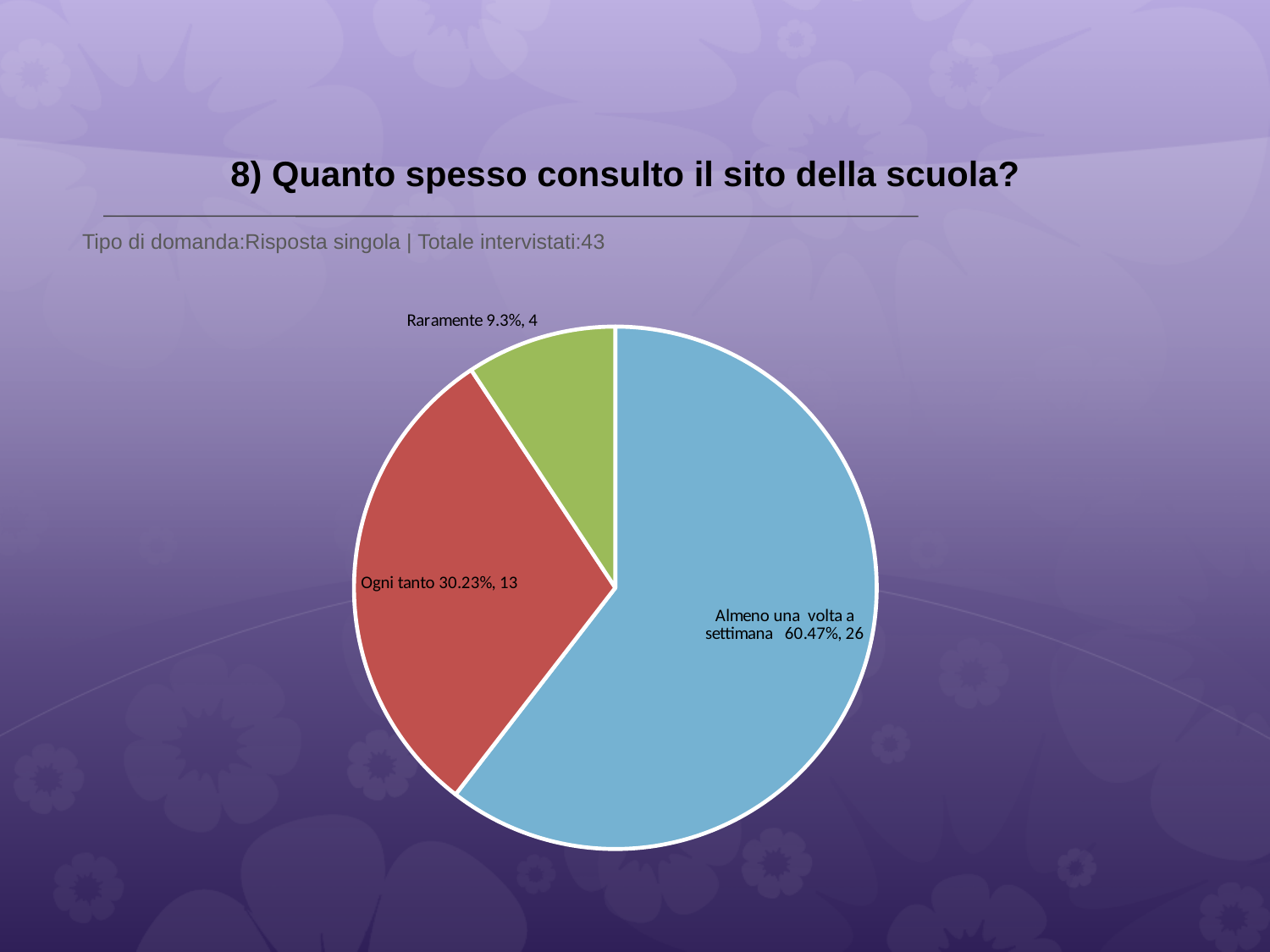
How many respondents chose 'Raramente'? 4 How many slices does the pie chart have? 3 Which category has the smallest slice? Raramente What percentage share does the 'Almeno una volta a settimana' slice have? 60.47% What colour is the 'Ogni tanto' slice? red What is the difference in respondent count between 'Almeno una volta a settimana' and 'Ogni tanto'? 13 What percentage share does the 'Raramente' slice have? 9.3% Which has more respondents, 'Ogni tanto' or 'Raramente'? Ogni tanto What is the total number of respondents across all slices? 43 What kind of chart is shown on the slide? pie chart How many respondents chose 'Ogni tanto'? 13 Which category has the largest slice? Almeno una volta a settimana